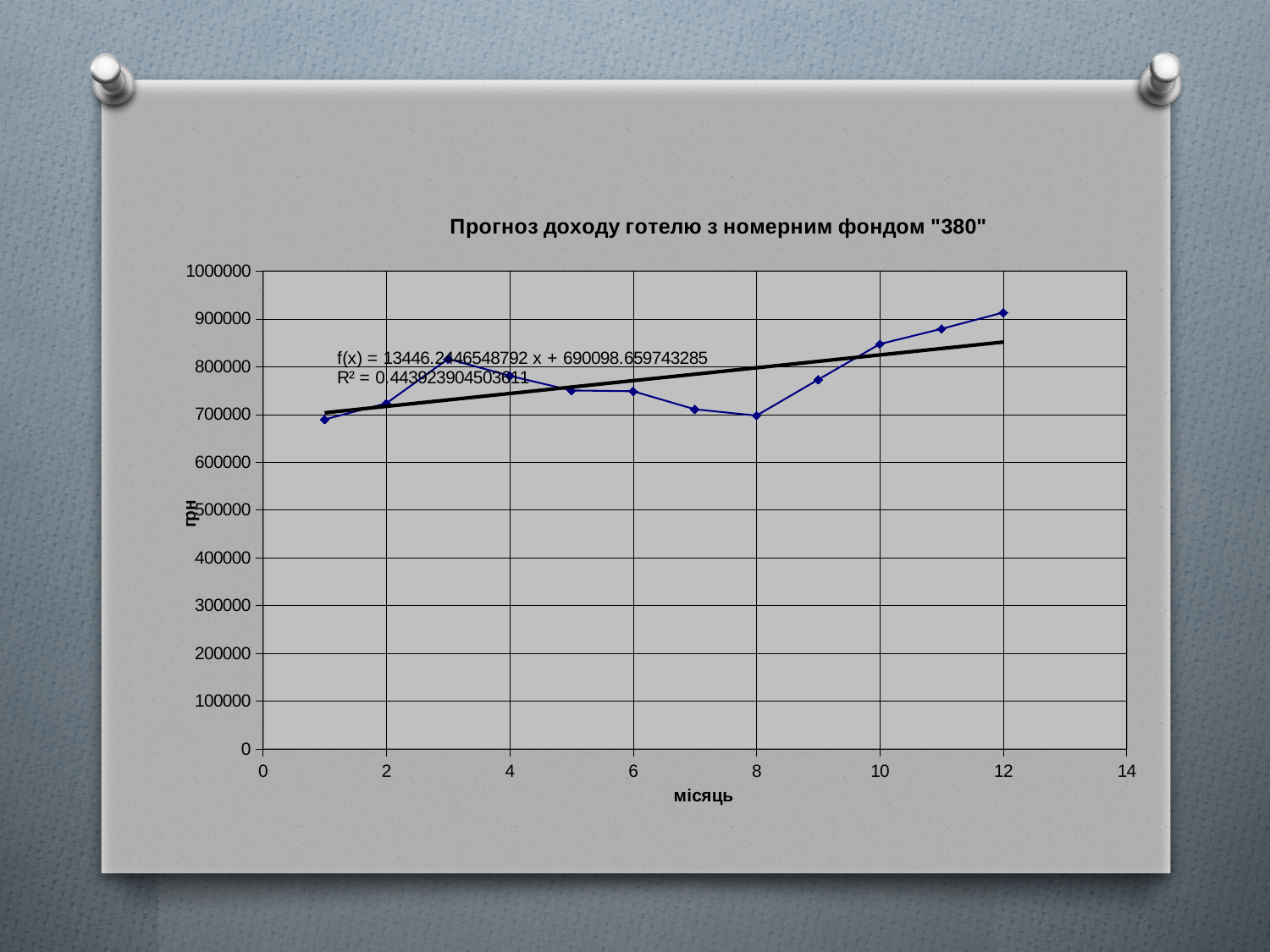
Is the value for month 8 greater or less than 800000? less Which month has the highest value? 12 Which is larger, the value for month 3 or the value for month 7? month 3 What is the title of the chart? Прогноз доходу готелю з номерним фондом "380" Is the value for month 12 greater or less than 800000? greater Is the value for month 1 greater or less than 800000? less What kind of chart is shown on the slide? line chart Which is larger, the value for month 12 or the value for month 8? month 12 What is the label of the x axis? місяць How many data points are plotted on the line? 12 Does the trend line rise or fall as the month increases? rises